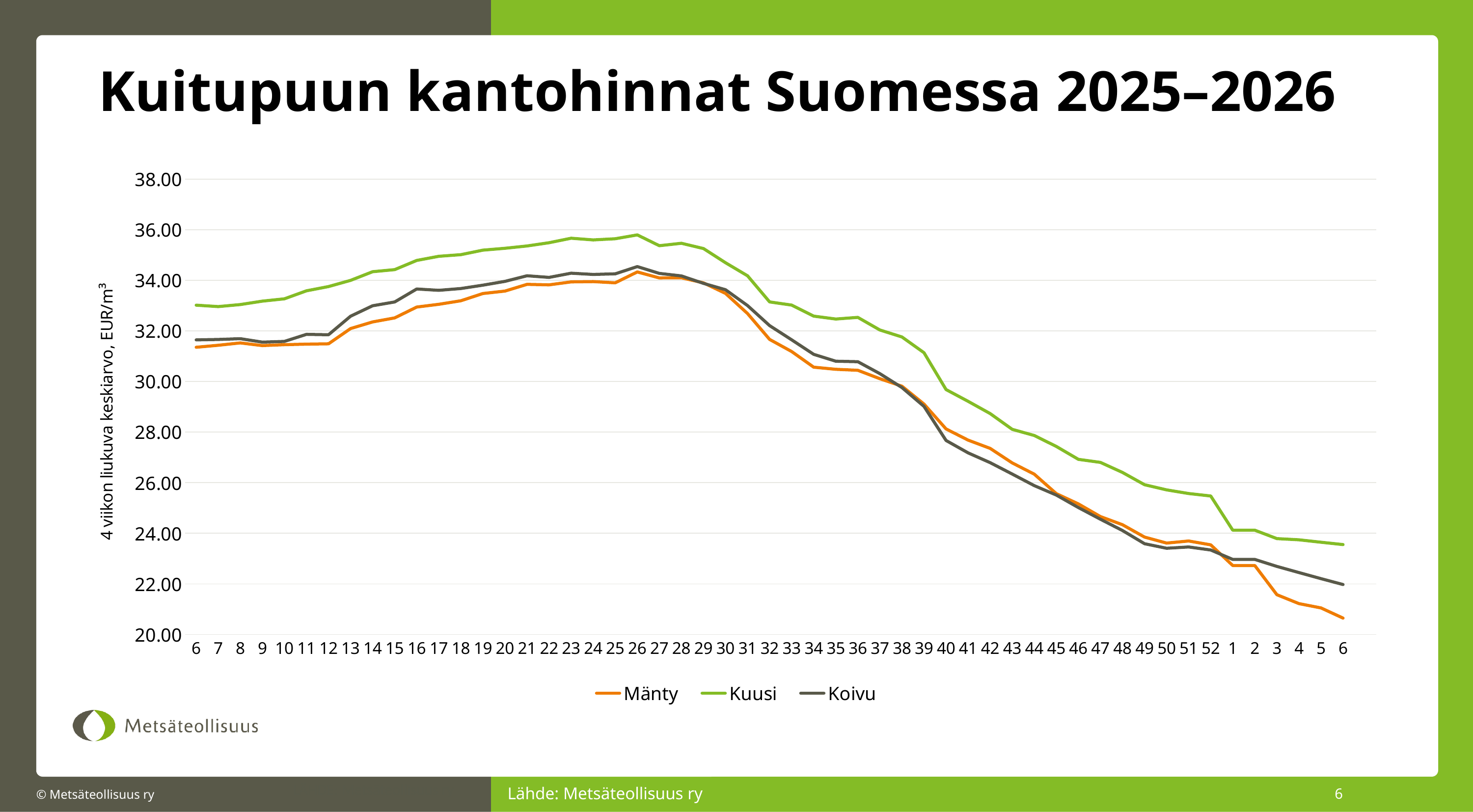
What is the title of the chart? Kuitupuun kantohinnat Suomessa 2025–2026 Is the value for Mänty at week 26 greater or less than 32.00? greater What kind of chart is shown on the slide? line chart How many series does the legend list? 3 Which series has the lowest value at the final week 6 on the right of the x axis? Mänty Is the value for Mänty at the final week 6 greater or less than 22.00? less Do the Mänty values rise or fall from week 26 to the final week 6? fall Is the value for Kuusi at week 26 greater or less than 34.00? greater Which series are listed in the legend? Mänty, Kuusi, Koivu At week 26, which series has the higher value, Kuusi or Mänty? Kuusi How many week labels are shown on the x axis? 53